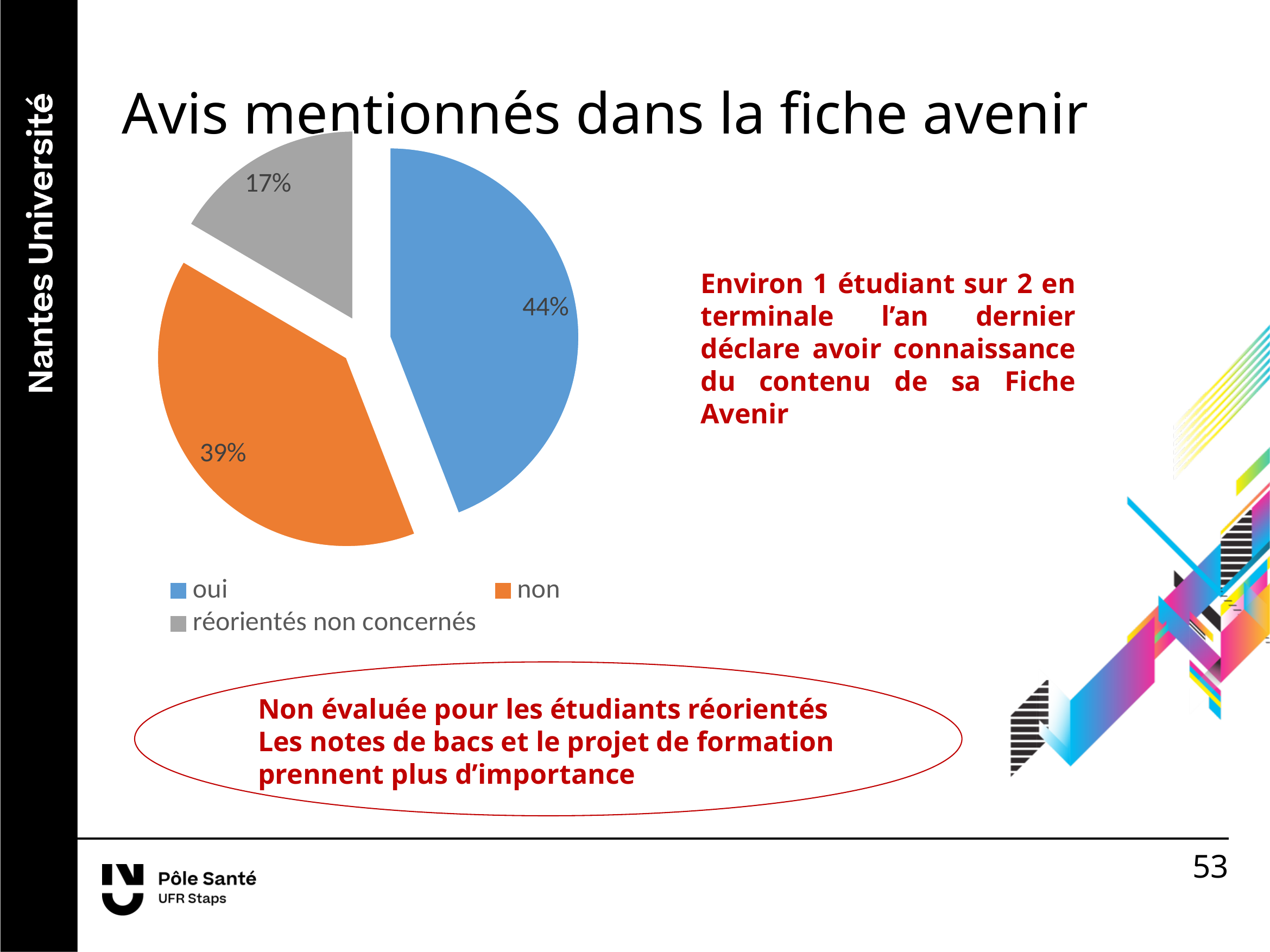
Which category has the smallest slice of the pie? réorientés non concernés Which category has the largest slice of the pie? oui What kind of chart is shown on the slide? pie chart What share of the pie does "oui" represent? 44% What share of the pie does "réorientés non concernés" represent? 17% What is the difference in percentage points between the "oui" and "non" slices? 5 What colour is the "non" slice in the pie chart? orange How many categories does the pie chart show? 3 What share of the pie does "non" represent? 39% Which category is shown in grey in the pie chart? réorientés non concernés What is the difference in percentage points between the "non" and "réorientés non concernés" slices? 22 Which slice is larger, "non" or "réorientés non concernés"? non